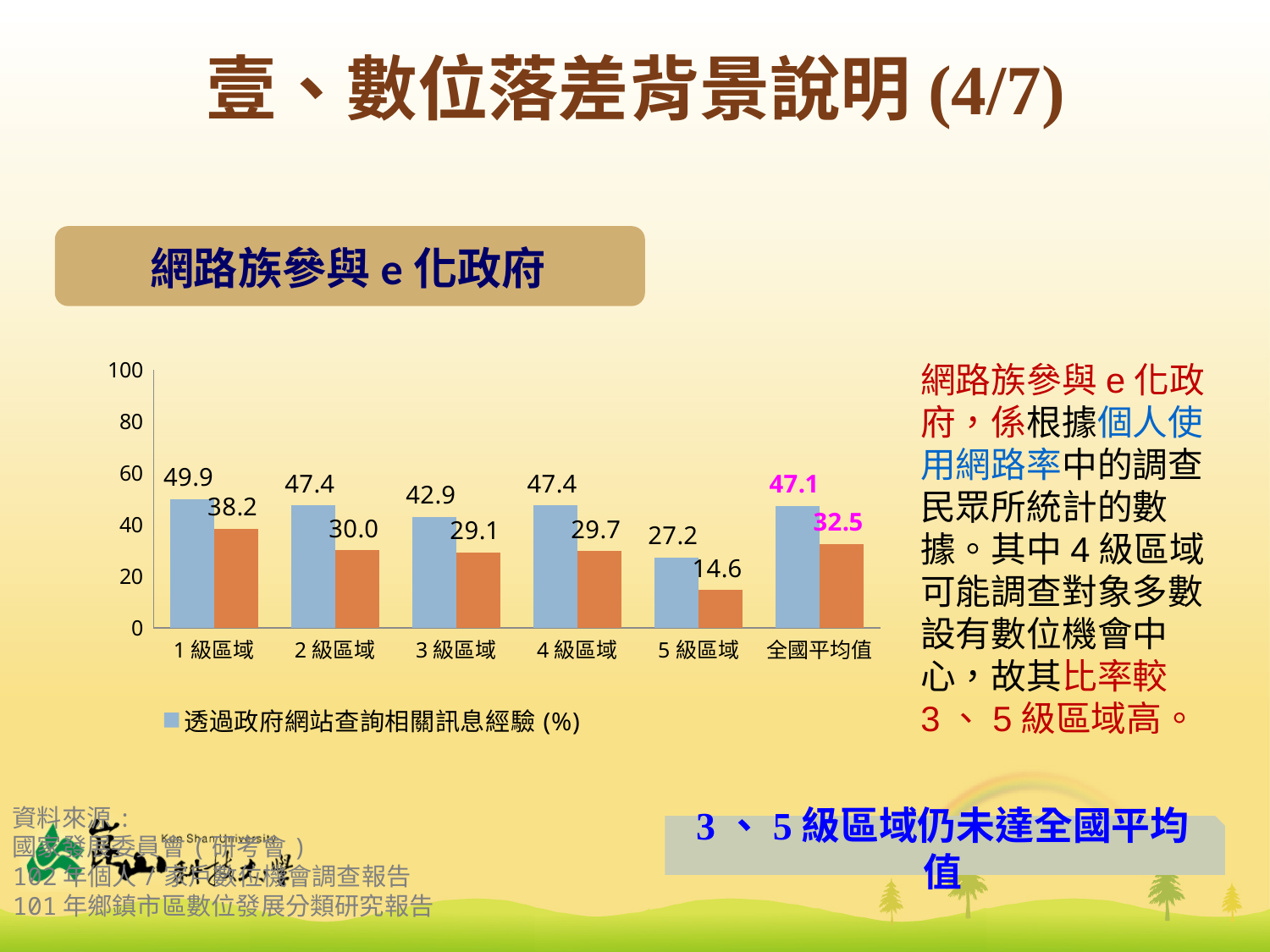
Is the blue bar value for 5級區域 greater or less than 40? less How many categories are shown on the x axis of the chart? 6 What is the value of the blue bar for 全國平均值? 47.1 Which category has the highest value in the blue series (透過政府網站查詢相關訊息經驗 (%))? 1級區域 What is the value of the orange bar for 2級區域? 30.0 What is the value of the orange bar for 5級區域? 14.6 Which category has the lowest value in the orange series? 5級區域 What is the value of the blue series (透過政府網站查詢相關訊息經驗 (%)) for 1級區域? 49.9 What is the title shown above the chart? 網路族參與 e 化政府 What kind of chart is shown on the slide? bar chart For 1級區域, what is the difference between the blue bar (49.9) and the orange bar (38.2)? 11.7 In the blue series, which is larger: 3級區域 or 4級區域? 4級區域